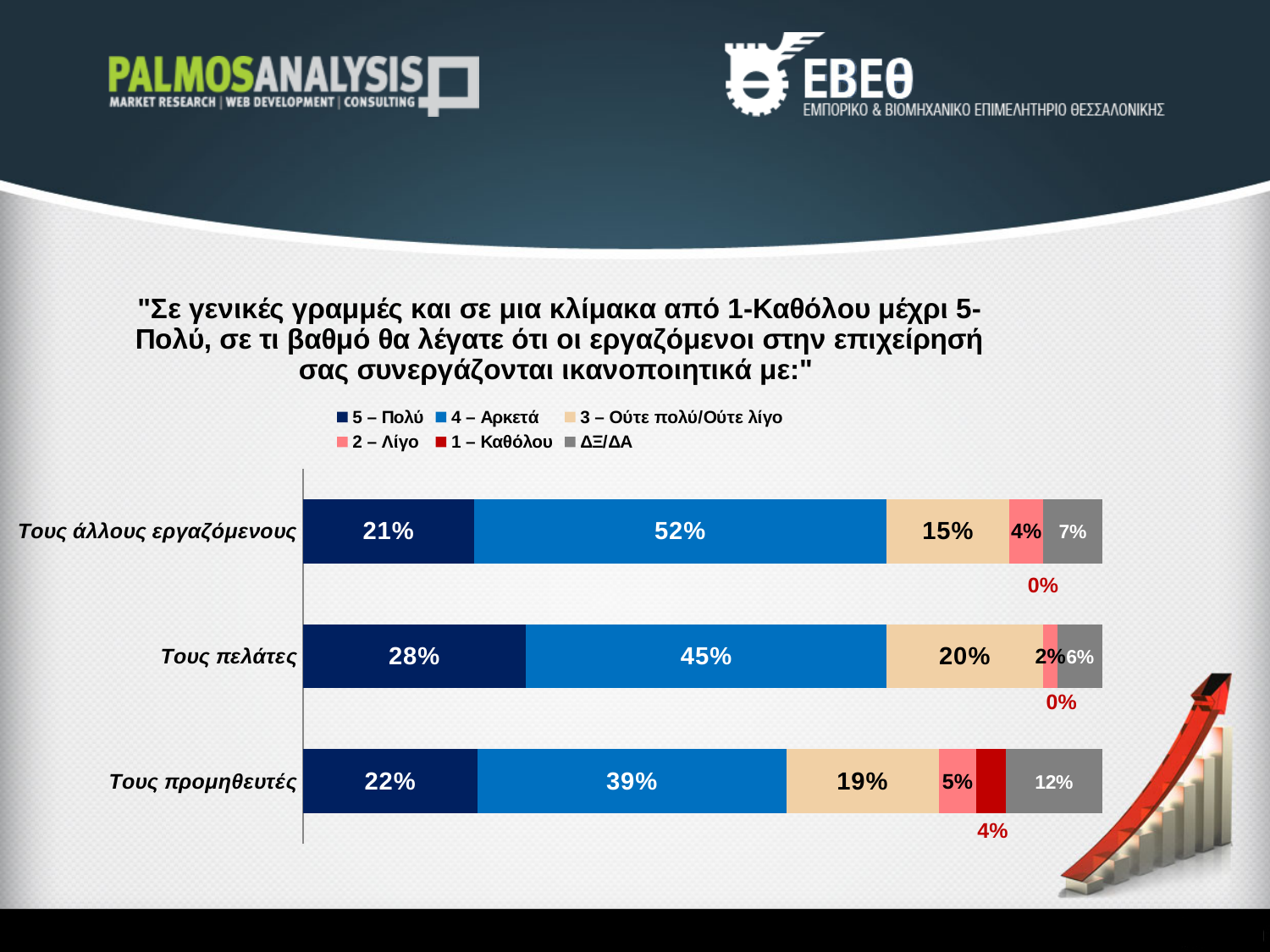
What kind of chart is shown on the slide? stacked bar chart What is the value of "5 – Πολύ" for "Τους πελάτες"? 28% How many categories are plotted on the chart? 3 What is the difference between the "4 – Αρκετά" values for "Τους άλλους εργαζόμενους" and "Τους προμηθευτές"? 13% Which category has the highest value for "5 – Πολύ"? Τους πελάτες Which category has the lowest value for "4 – Αρκετά"? Τους προμηθευτές What is the value of "4 – Αρκετά" for "Τους άλλους εργαζόμενους"? 52% How many series does the legend list? 6 What is the value of "1 – Καθόλου" for "Τους προμηθευτές"? 4% Which is larger: the "3 – Ούτε πολύ/Ούτε λίγο" value for "Τους πελάτες" or for "Τους άλλους εργαζόμενους"? Τους πελάτες What is the value of "ΔΞ/ΔΑ" for "Τους προμηθευτές"? 12% Which legend entry is shown in the darkest blue colour? 5 – Πολύ